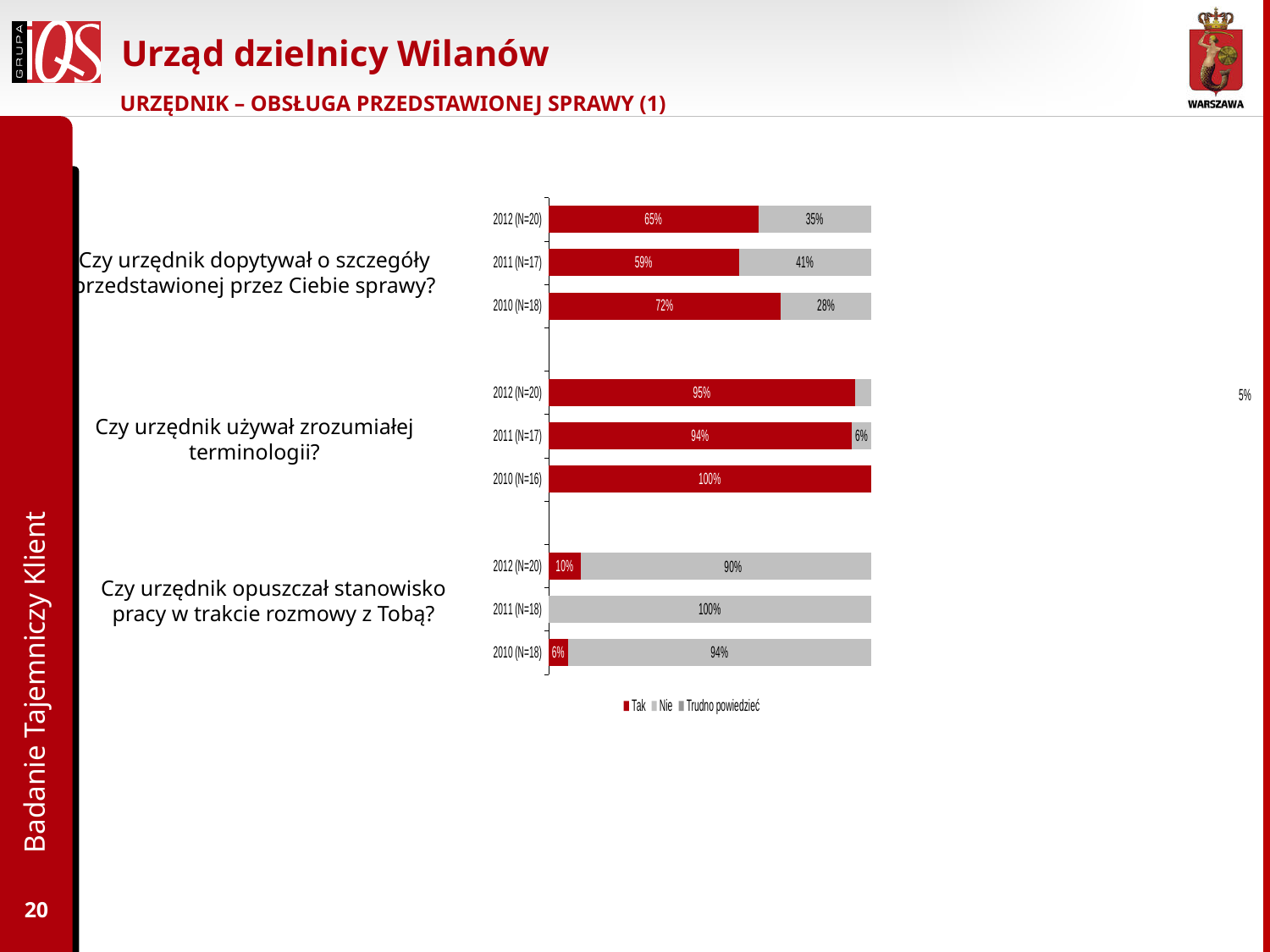
For the question 'Czy urzędnik dopytywał o szczegóły przedstawionej przez Ciebie sprawy?', which year has the highest 'Tak' share? 2010 (N=18) For the question 'Czy urzędnik opuszczał stanowisko pracy w trakcie rozmowy z Tobą?', is the 'Tak' share larger in 2012 (N=20) or in 2010 (N=18)? 2012 (N=20) What are the legend entries of the chart? Tak, Nie, Trudno powiedzieć For the question 'Czy urzędnik dopytywał o szczegóły przedstawionej przez Ciebie sprawy?', what is the 'Nie' share in 2011 (N=17)? 41% For the question 'Czy urzędnik opuszczał stanowisko pracy w trakcie rozmowy z Tobą?', what is the 'Nie' share in 2011 (N=18)? 100% How many bars (year rows) are plotted in the chart in total? 9 For the question 'Czy urzędnik używał zrozumiałej terminologii?', what is the 'Tak' share in 2012 (N=20)? 95% For the question 'Czy urzędnik dopytywał o szczegóły przedstawionej przez Ciebie sprawy?', what is the 'Tak' share in 2012 (N=20)? 65% For the question 'Czy urzędnik dopytywał o szczegóły przedstawionej przez Ciebie sprawy?', what is the difference between the 'Tak' share in 2010 (N=18) and in 2011 (N=17)? 13 percentage points For the question 'Czy urzędnik używał zrozumiałej terminologii?', what is the 'Tak' share in 2010 (N=16)? 100% What type of chart is shown on the slide? stacked bar chart How many series does the chart legend list? 3